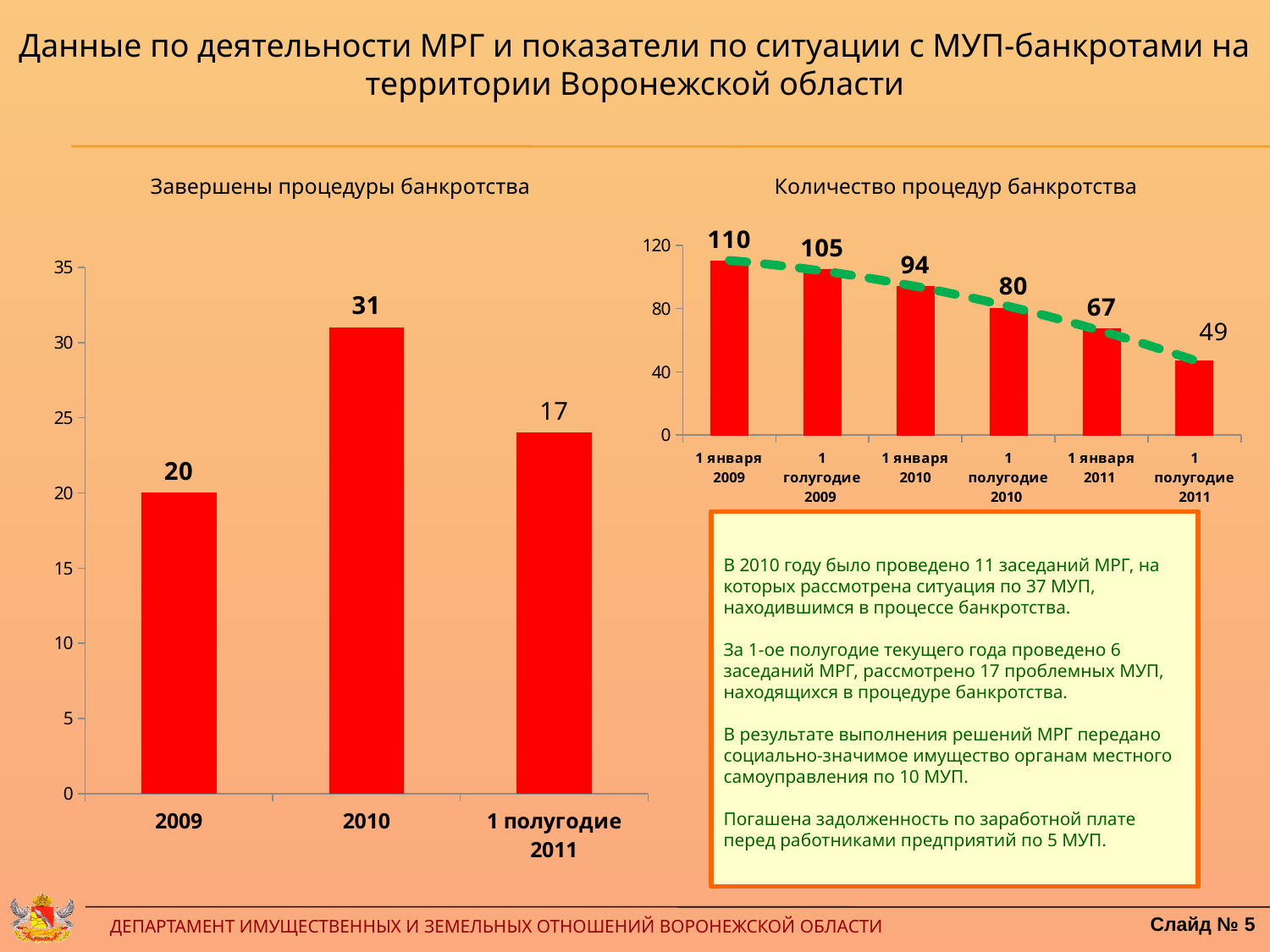
In the chart 'Количество процедур банкротства', do the values rise or fall from left to right along the x axis? fall In the chart 'Количество процедур банкротства', what is the value for 1 января 2010? 94 In the chart 'Завершены процедуры банкротства', what is the value for 1 полугодие 2011? 17 In the chart 'Количество процедур банкротства', how many bars are plotted? 6 In the chart 'Количество процедур банкротства', what is the difference between the values for 1 января 2009 and 1 полугодие 2011? 61 In the chart 'Завершены процедуры банкротства', what is the difference between the values for 2010 and 2009? 11 In the chart 'Завершены процедуры банкротства', how many categories are shown on the x axis? 3 In the chart 'Количество процедур банкротства', which category has the lowest value? 1 полугодие 2011 In the chart 'Завершены процедуры банкротства', what is the value for 2010? 31 In the chart 'Завершены процедуры банкротства', which category has the highest value? 2010 What kind of chart is the chart 'Завершены процедуры банкротства'? bar chart In the chart 'Количество процедур банкротства', what is the value for 1 полугодие 2011? 49